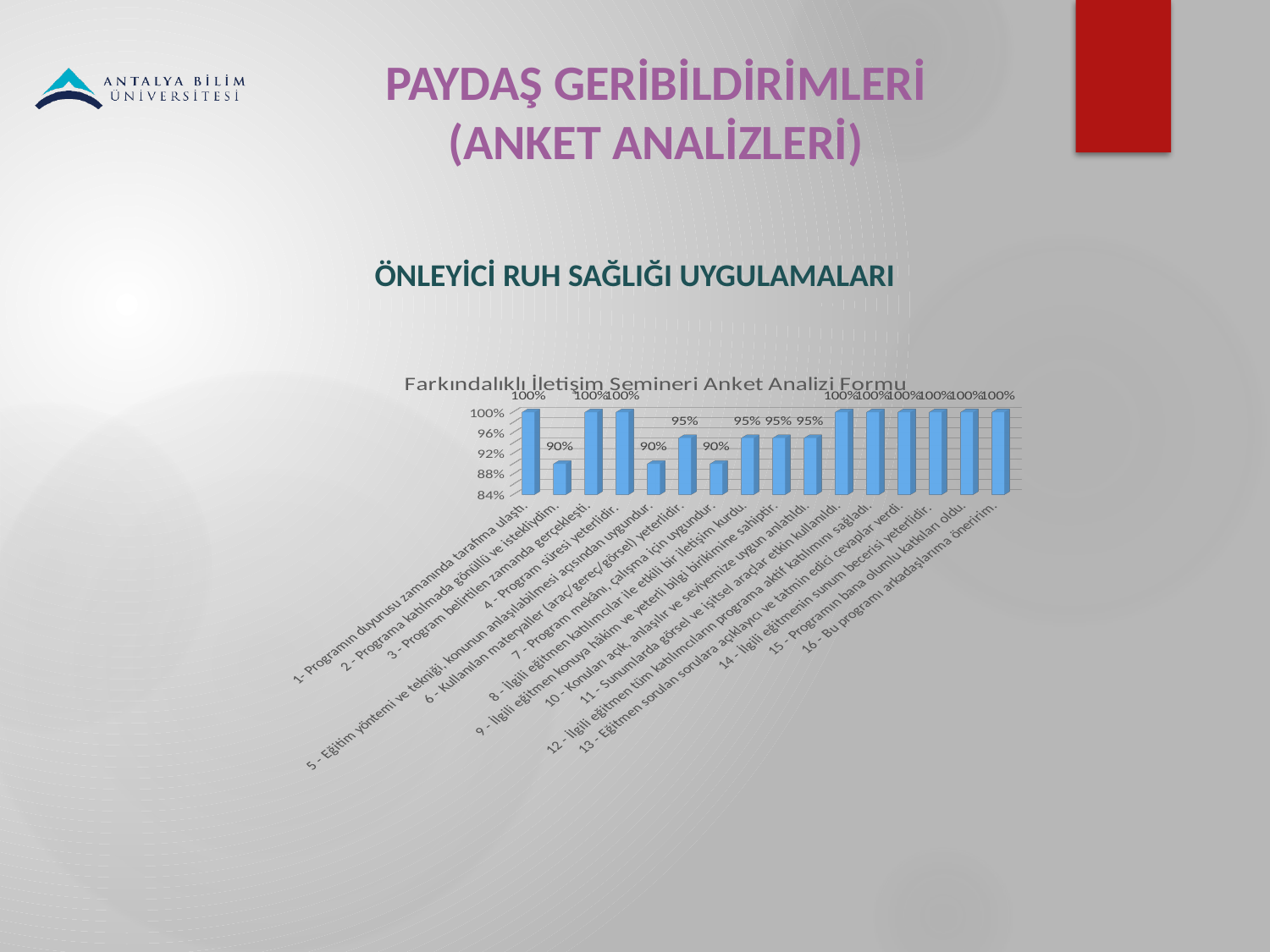
What is the highest value shown in the chart? 100% What kind of chart is shown on the slide? bar chart What is the value for item 16 (Bu programı arkadaşlarıma öneririm)? 100% What is the lowest value shown in the chart? 90% What is the difference between the value for item 1 and the value for item 2? 10% What is the title of the chart? Farkındalıklı İletişim Semineri Anket Analizi Formu Which is larger, the value for item 8 or the value for item 5? item 8 What is the value for item 6 (Kullanılan materyaller (araç/gereç/görsel) yeterlidir)? 95% What is the value for item 7 (Program mekânı, çalışma için uygundur)? 90% What is the difference between the value for item 9 and the value for item 7? 5% What is the value for item 2 (Programa katılmada gönüllü ve istekliydim)? 90% How many categories (survey items) are plotted in the chart? 16